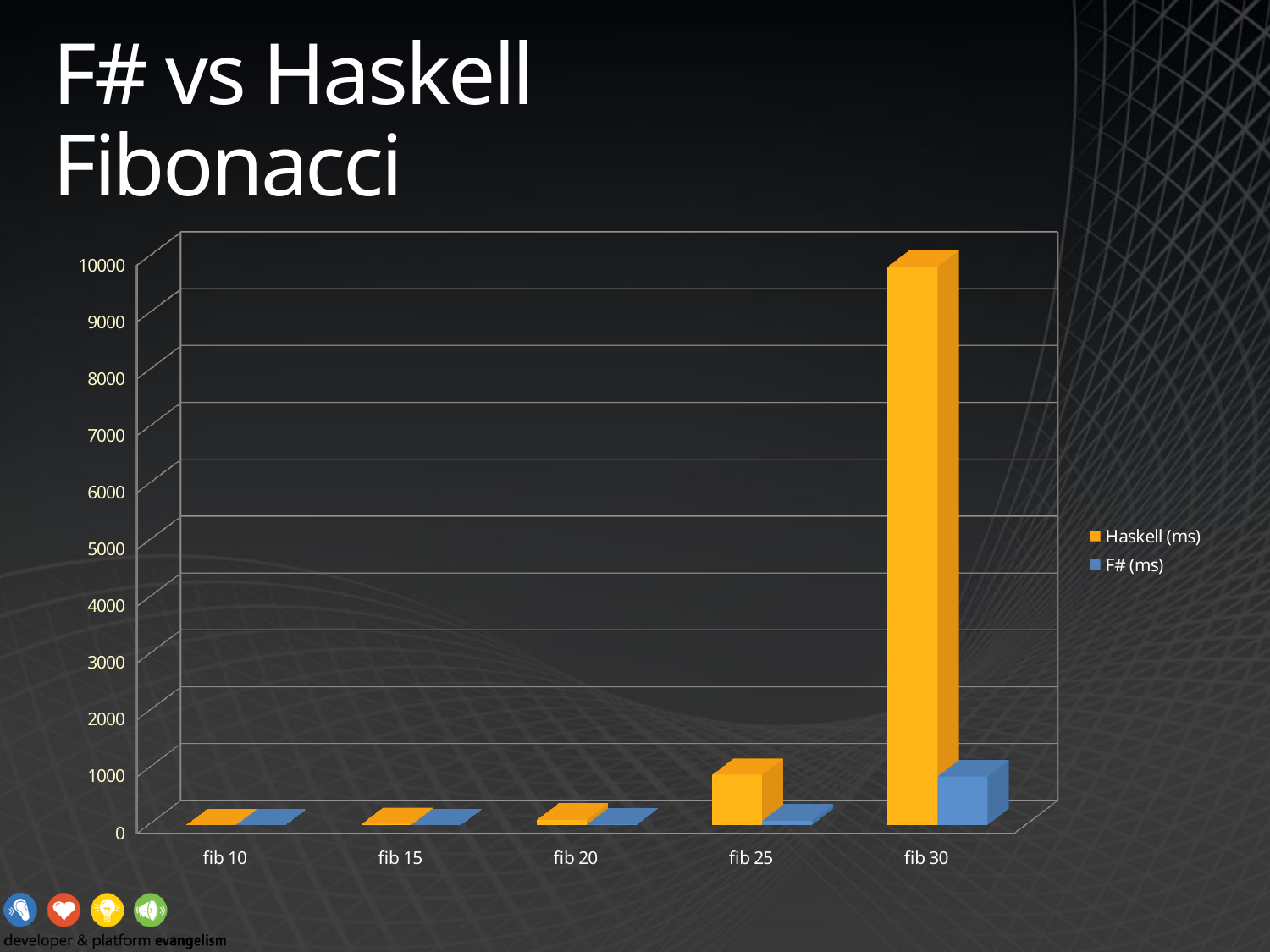
For fib 30, which series has the larger value, Haskell (ms) or F# (ms)? Haskell (ms) Is the F# (ms) value for fib 30 greater or less than 3000? less What is the title of the slide containing the chart? F# vs Haskell Fibonacci How many series does the legend list? 2 Is the Haskell (ms) value for fib 25 greater or less than 2000? less How many categories are shown on the x axis? 5 Which category has the highest Haskell (ms) value? fib 30 Is the Haskell (ms) value for fib 10 greater or less than 1000? less Do the Haskell (ms) values rise or fall from fib 10 to fib 30? rise What kind of chart is shown on the slide? bar chart Which category has the highest F# (ms) value? fib 30